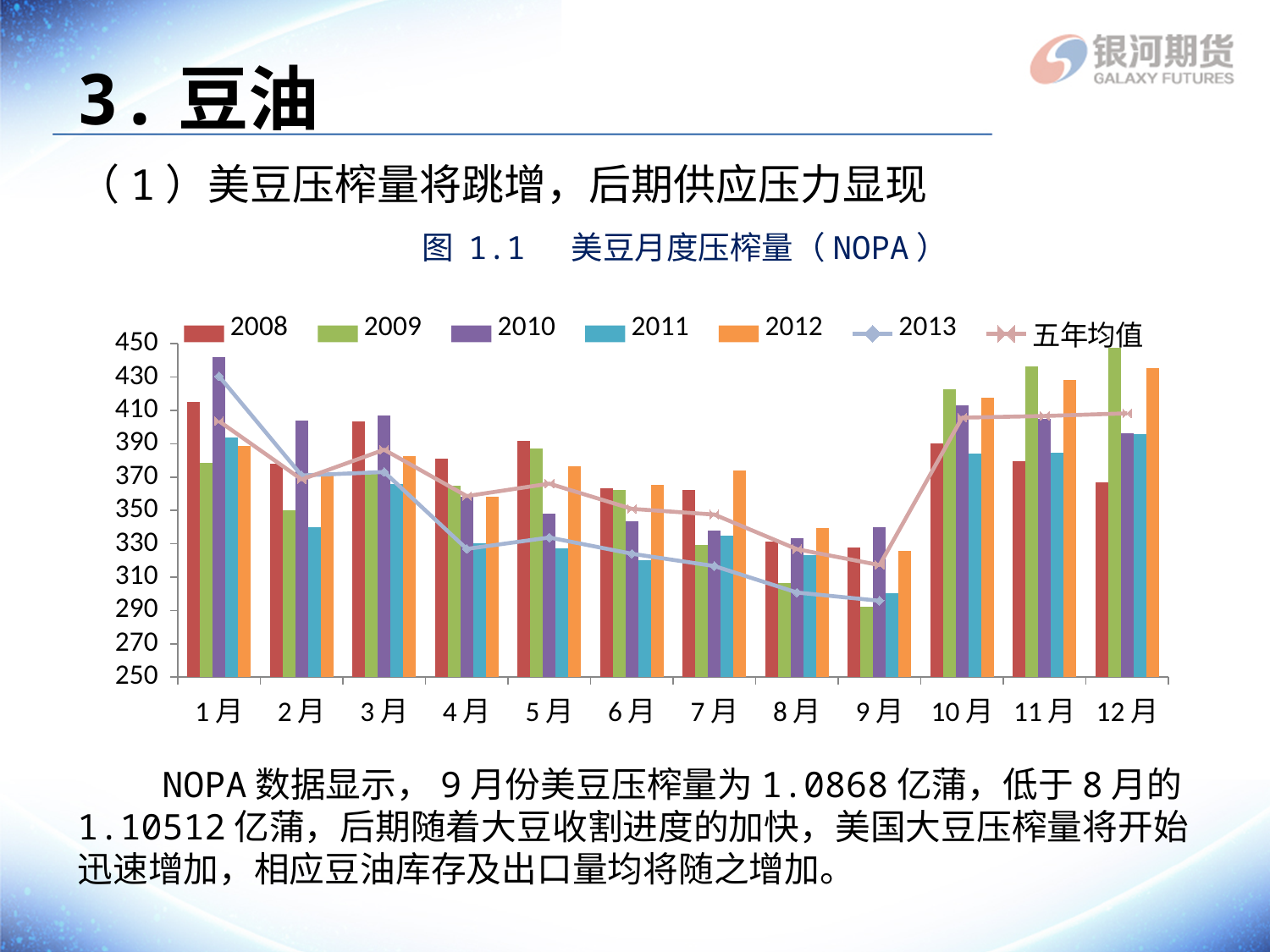
How many months are shown on the x axis? 12 Is the value for 2011 in 2月 greater or less than 350? less In which month is the 2009 bar the highest? 12月 Does the 2013 line rise or fall from 1月 to 9月? Fall In which month is the 2009 bar the lowest? 9月 In 10月, which is larger, the 2009 bar or the 2008 bar? 2009 What kind of chart is shown on the slide? Bar chart with line series What is the title of the chart? 图 1.1 美豆月度压榨量（NOPA） How many series does the legend list? 7 Which legend entry is plotted as a line with x markers? 五年均值 In which month does the 2013 line reach its lowest point? 9月 Is the value for 2009 in 12月 greater or less than 430? greater